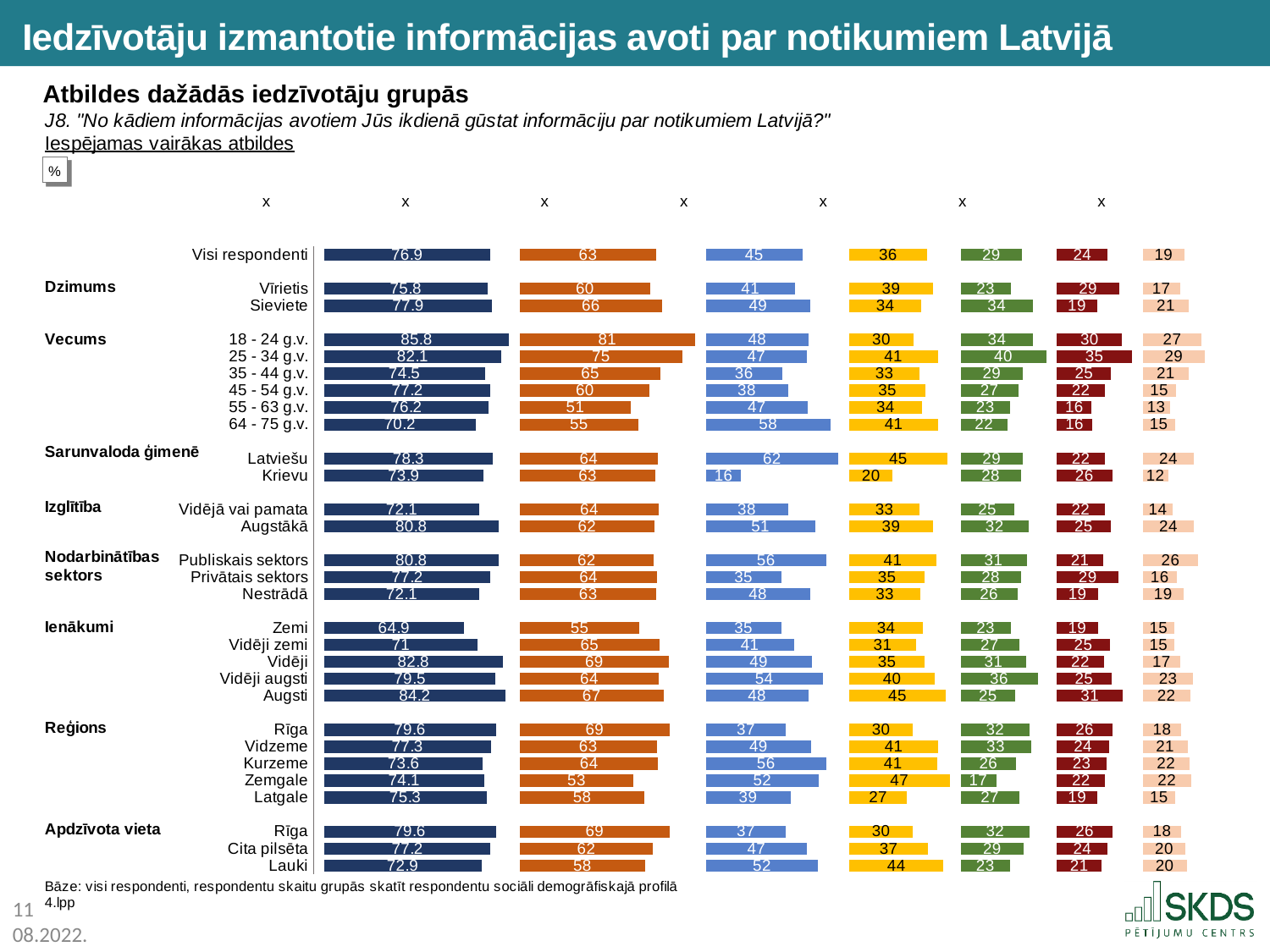
What is the value of the first (dark blue) bar for Visi respondenti? 76.9 Among the Reģions categories, which has the highest value in the fourth (yellow) series? Zemgale What is the value of the last (light peach) bar for Lauki? 20 In the third (light blue) series, what is the difference between Latviešu and Krievu? 46 In the third (light blue) series, what is the difference between Publiskais sektors and Privātais sektors? 21 Among the Ienākumi groups, which has the lowest value in the first (dark blue) series? Zemi How many bars (series) are shown for each category row? 7 Among the Vecums age groups, which has the highest value in the first (dark blue) series? 18 - 24 g.v. What is the value of the third (light blue) bar for Krievu? 16 In the second (orange) series, which is larger: Vīrietis or Sieviete? Sieviete What is the value of the fourth (yellow) bar for Augsti in the Ienākumi group? 45 How many categories are listed under Reģions? 5